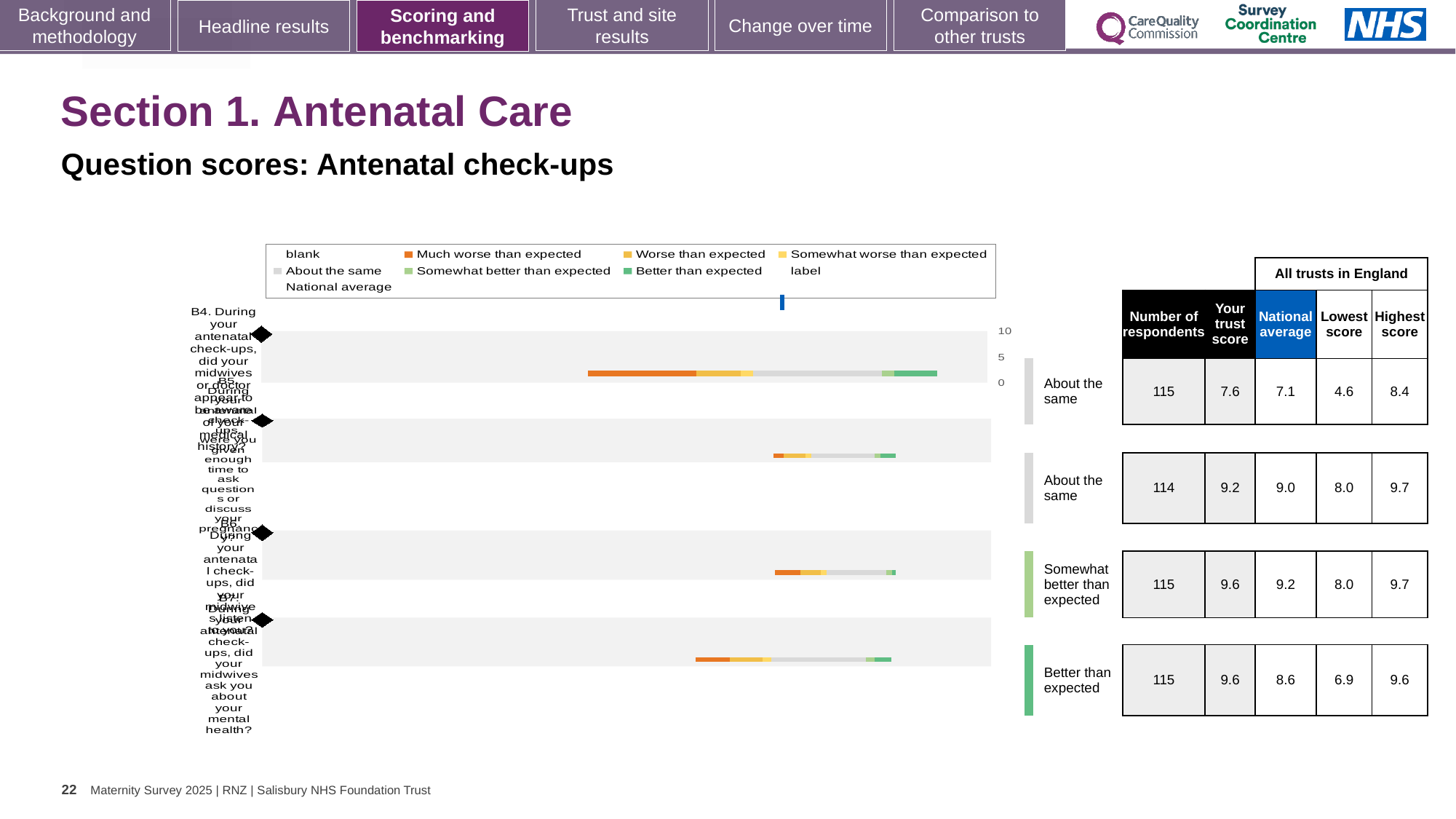
Which colour does the legend use for 'Much worse than expected'? orange What kind of chart is shown on the slide? bar chart In the table beside the chart, how many respondents are listed for the second row (B5)? 114 Which colour does the legend use for 'Better than expected'? green In the table beside the chart, which row has the lowest trust score? the first row (B4), 7.6 In the table beside the chart, is the trust score for the third row (B6) larger or smaller than its national average? larger In the table beside the chart, what is the national average for the first row (B4)? 7.1 In the table beside the chart, what is the difference between the trust score and the national average for the fourth row (B7)? 1.0 How many question rows (bars) does the chart show? 4 In the table beside the chart, what is the lowest score for the fourth row (B7, benchmarked 'Better than expected')? 6.9 How many entries does the chart legend list? 9 In the table beside the chart, what is the trust score for the first row (B4, benchmarked 'About the same')? 7.6